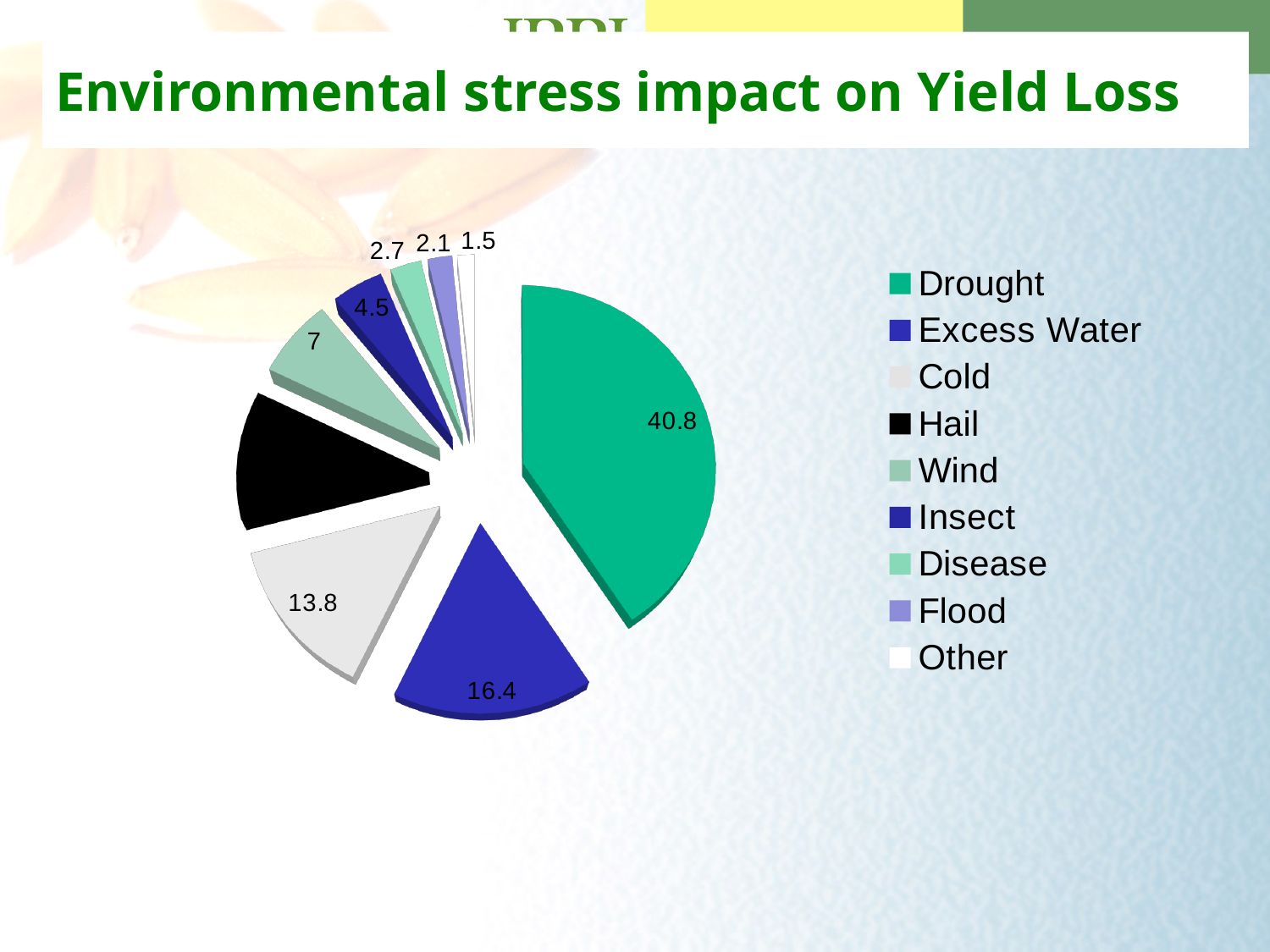
Which category has the largest slice of the pie chart? Drought Which category has the smallest slice of the pie chart? Other What value is shown for Drought in the pie chart? 40.8 What is the difference between the values for Drought and Excess Water? 24.4 How many categories does the legend of the pie chart list? 9 What value is shown for Cold in the pie chart? 13.8 What value is shown for Flood in the pie chart? 2.1 Which is larger, the value for Cold or the value for Excess Water? Excess Water What type of chart is shown on the slide? Pie chart What value is shown for Excess Water in the pie chart? 16.4 What value is shown for Insect in the pie chart? 4.5 What value is shown for Wind in the pie chart? 7